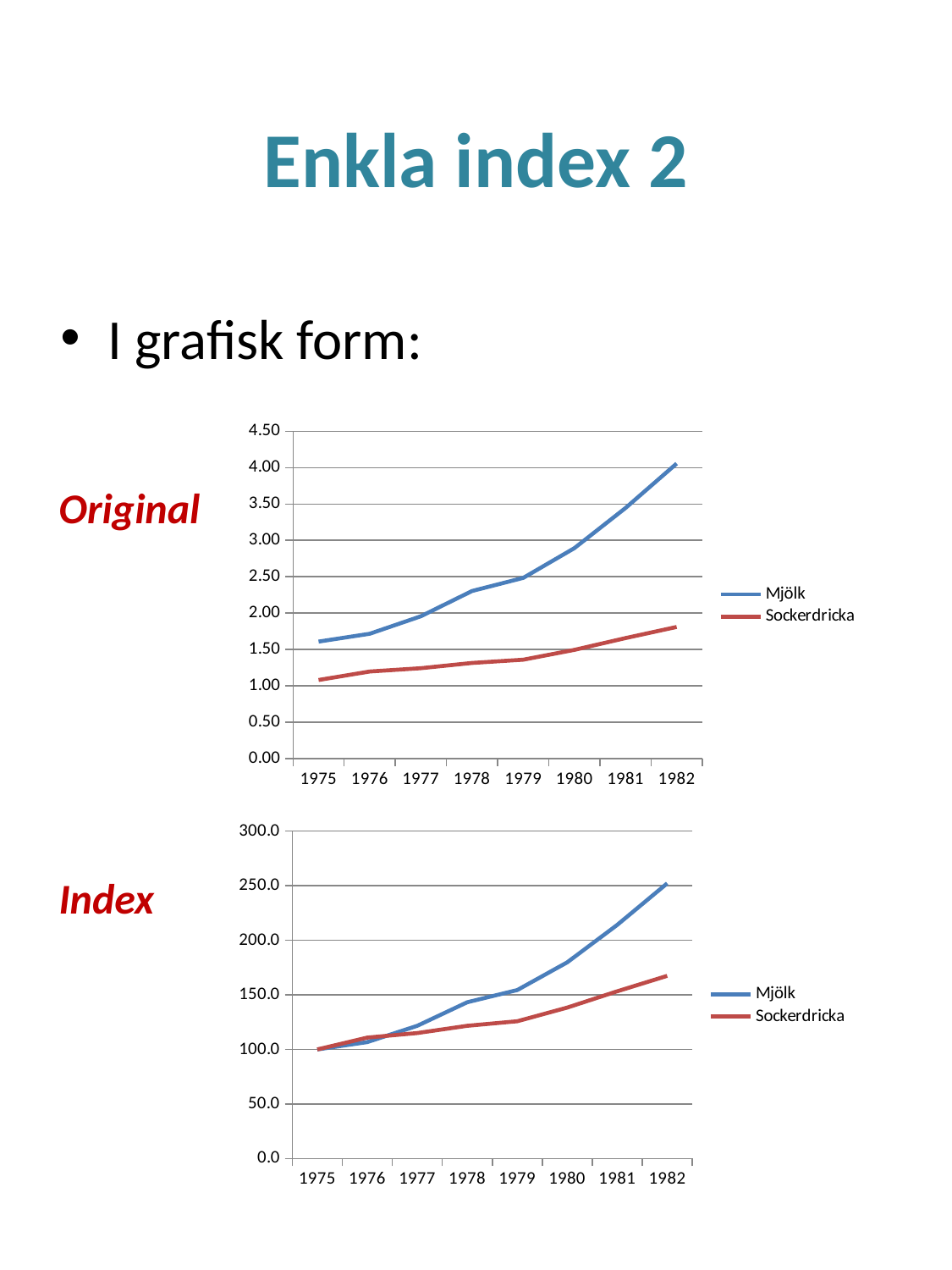
In the bottom chart labelled Index, do the values for Mjölk rise or fall from 1975 to 1982? rise In the bottom chart labelled Index, what is the value for Sockerdricka in 1975? 100.0 How many series does the legend of the bottom chart labelled Index list? 2 What colour is the Sockerdricka line in the top chart labelled Original? red What kind of chart is the top chart labelled Original? line chart In the bottom chart labelled Index, is the value for Sockerdricka in 1982 greater or less than 200.0? less In the top chart labelled Original, which series has the higher value in 1982, Mjölk or Sockerdricka? Mjölk In the bottom chart labelled Index, what is the value for Mjölk in 1975? 100.0 How many years are shown on the x axis of the top chart labelled Original? 8 In the bottom chart labelled Index, is the value for Mjölk in 1980 greater or less than 150.0? greater In the top chart labelled Original, is the value for Mjölk in 1975 greater or less than 1.50? greater